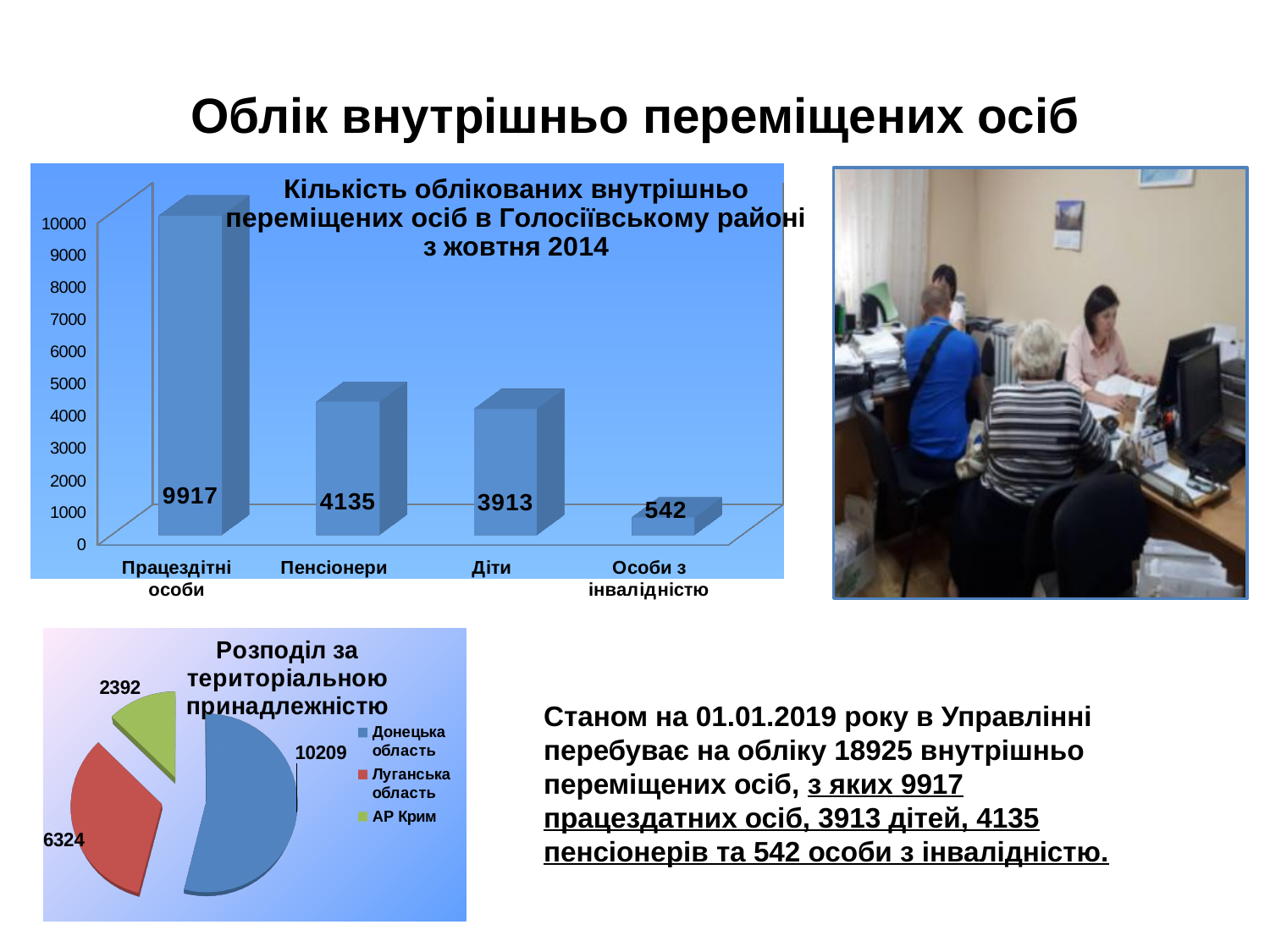
In the bar chart, which category has the lowest value? Особи з інвалідністю In the bar chart, what is the difference between the values for Пенсіонери and Діти? 222 What kind of chart is the chart at the top left of the slide? bar chart In the pie chart 'Розподіл за територіальною приналежністю', what is the value for Луганська область? 6324 In the bar chart, which is larger: the value for Працездітні особи or the value for Пенсіонери? Працездітні особи In the bar chart, which category has the highest value? Працездітні особи In the pie chart 'Розподіл за територіальною приналежністю', which region has the largest slice? Донецька область In the bar chart, what is the value for Особи з інвалідністю? 542 How many entries does the legend of the pie chart list? 3 In the bar chart, what is the value for Пенсіонери? 4135 In the pie chart 'Розподіл за територіальною приналежністю', what is the total of all slices? 18925 How many categories does the bar chart show? 4